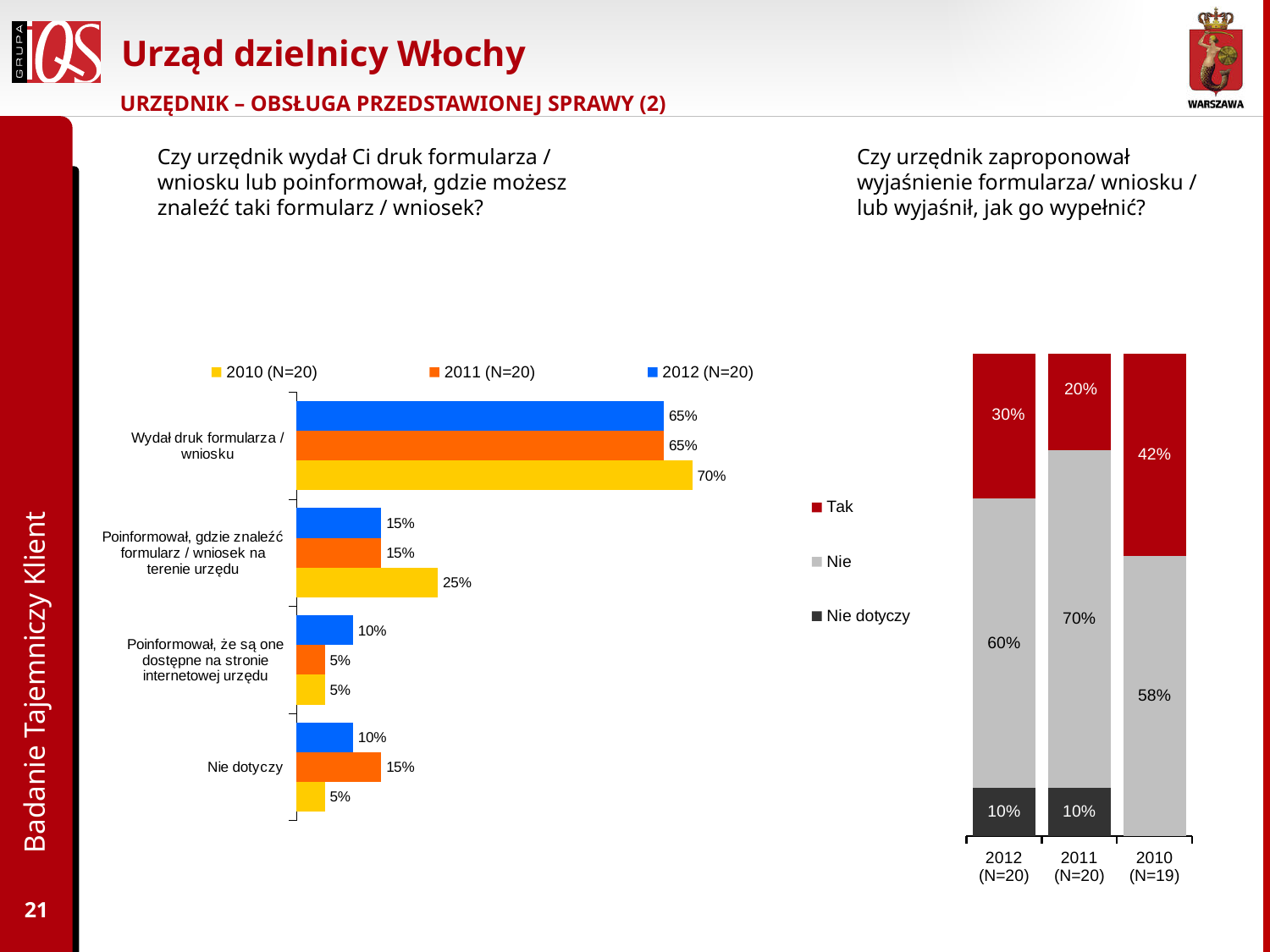
In the left chart, what is the value for 'Poinformował, że są one dostępne na stronie internetowej urzędu' in 2012 (N=20)? 10% In the left chart, how many series does the legend list? 3 What kind of chart is the chart on the right? Stacked bar chart In the left chart, what is the value for 'Nie dotyczy' in 2011 (N=20)? 15% In the left chart, what is the difference between the 2010 and 2012 values for 'Poinformował, gdzie znaleźć formularz / wniosek na terenie urzędu'? 10% In the right chart, what is the 'Tak' value for 2010 (N=19)? 42% In the right chart, what is the difference between the 'Tak' values for 2012 (N=20) and 2011 (N=20)? 10% In the left chart, what is the value for 'Wydał druk formularza / wniosku' in 2010 (N=20)? 70% In the right chart, what is the 'Nie' value for 2011 (N=20)? 70% In the left chart, how many categories are shown? 4 In the left chart, which category has the highest value for 2012 (N=20)? Wydał druk formularza / wniosku In the right chart, which year has the highest 'Tak' value? 2010 (N=19)